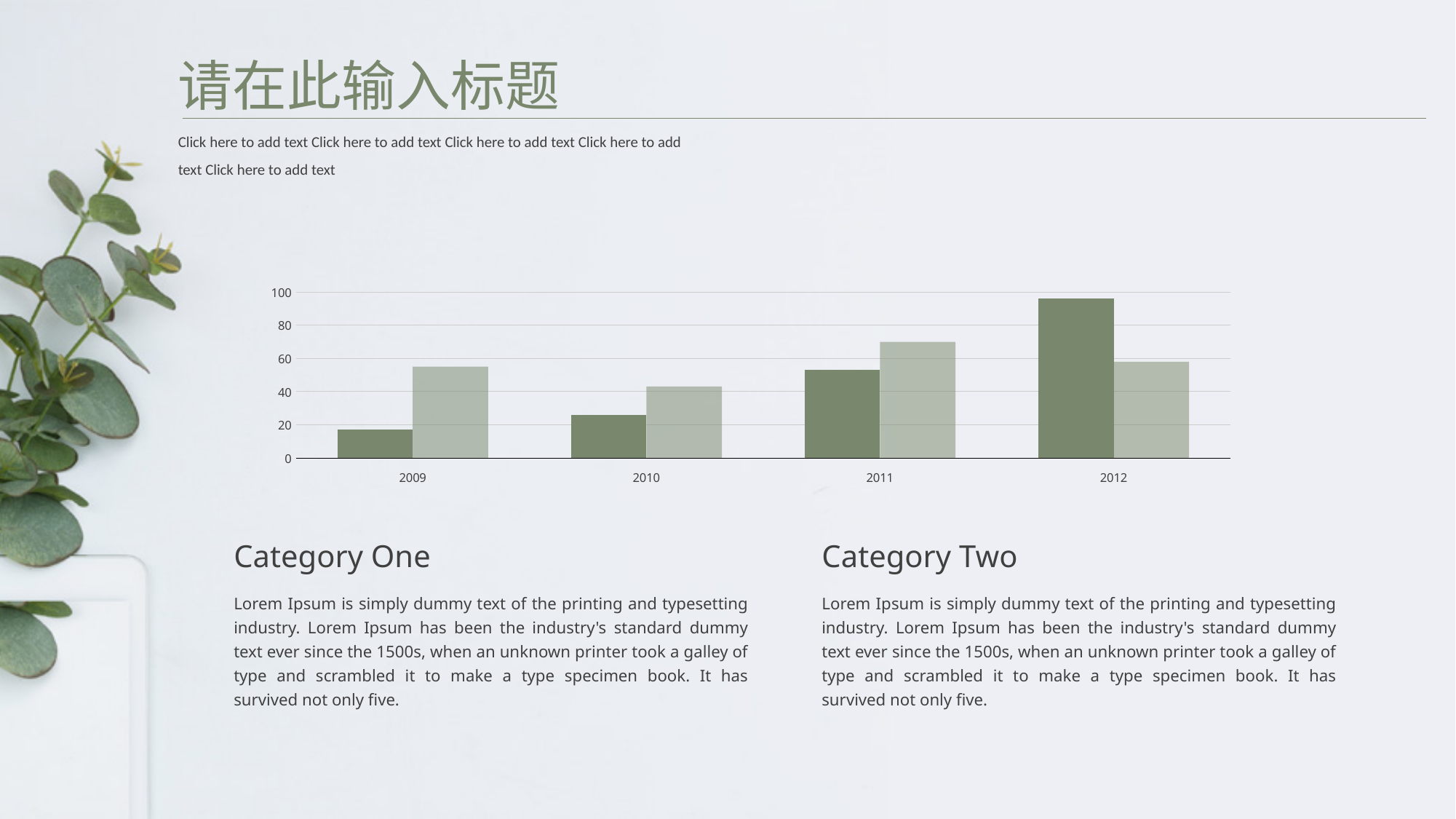
In which year is the dark green bar the shortest? 2009 Is the value of the light green bar for 2011 greater or less than 60? greater For 2009, which bar is taller, the dark green or the light green one? light green How many bars are shown for each year in the chart? 2 In which year is the light green bar the tallest? 2011 What kind of chart is shown on the slide? bar chart Is the value of the dark green bar for 2009 greater or less than 20? less Is the value of the dark green bar for 2012 greater or less than 80? greater Do the dark green bars rise or fall from 2009 to 2012? rise For 2012, which bar is taller, the dark green or the light green one? dark green How many years are shown on the x axis of the chart? 4 In which year is the dark green bar the tallest? 2012